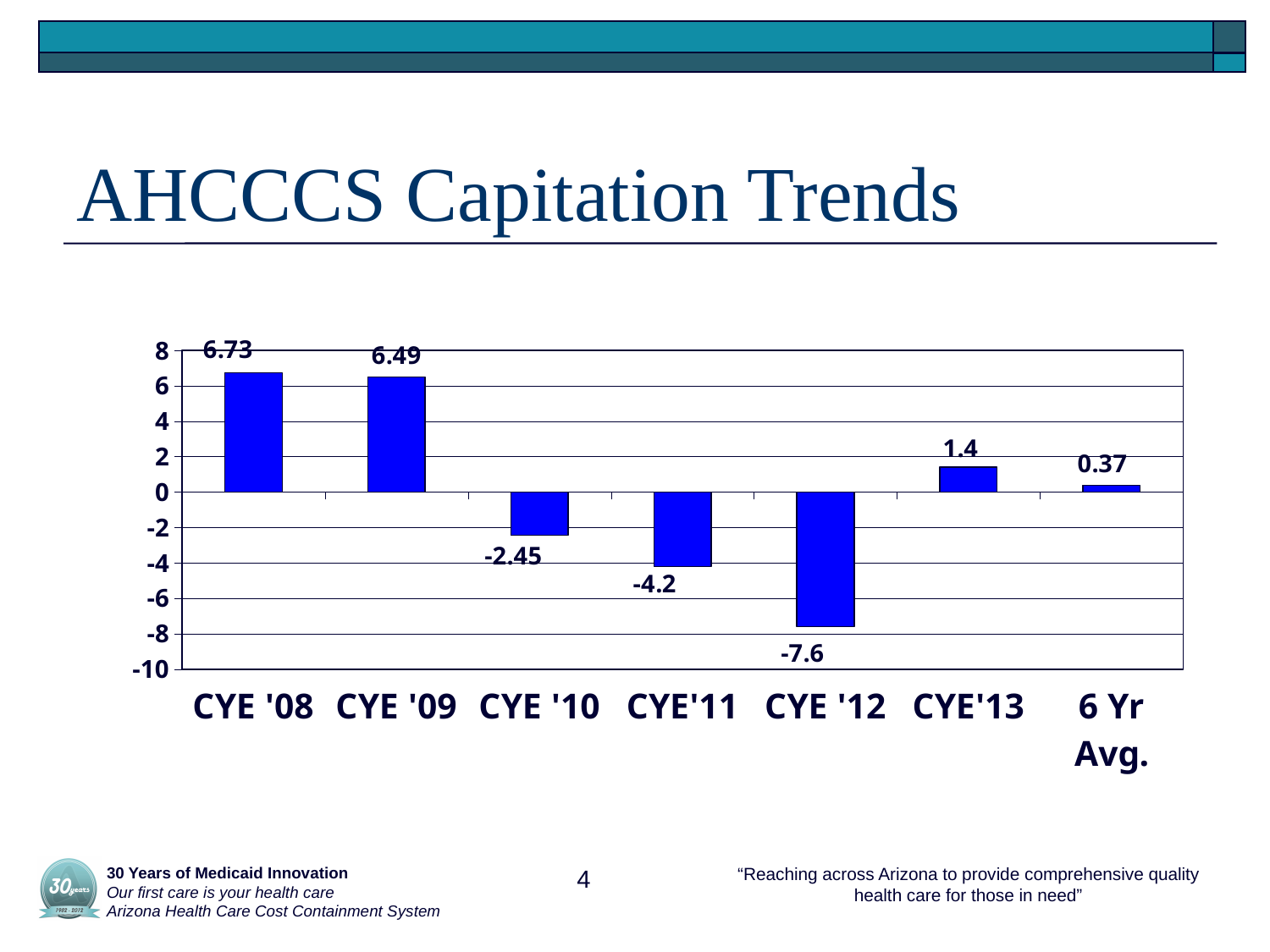
What kind of chart is shown on the slide? Bar chart Which category has the highest value? CYE '08 Which is larger, the value for CYE '10 or the value for CYE'11? CYE '10 What is the value for the 6 Yr Avg. category? 0.37 What is the title of the slide containing the chart? AHCCCS Capitation Trends What is the difference between the values for CYE '08 and CYE '09? 0.24 What is the value for CYE '08? 6.73 Do the values rise or fall from CYE '09 to CYE '12? Fall How many categories are shown on the x axis? 7 What is the value for CYE'13? 1.4 Which category has the lowest value? CYE '12 What is the value for CYE '12? -7.6